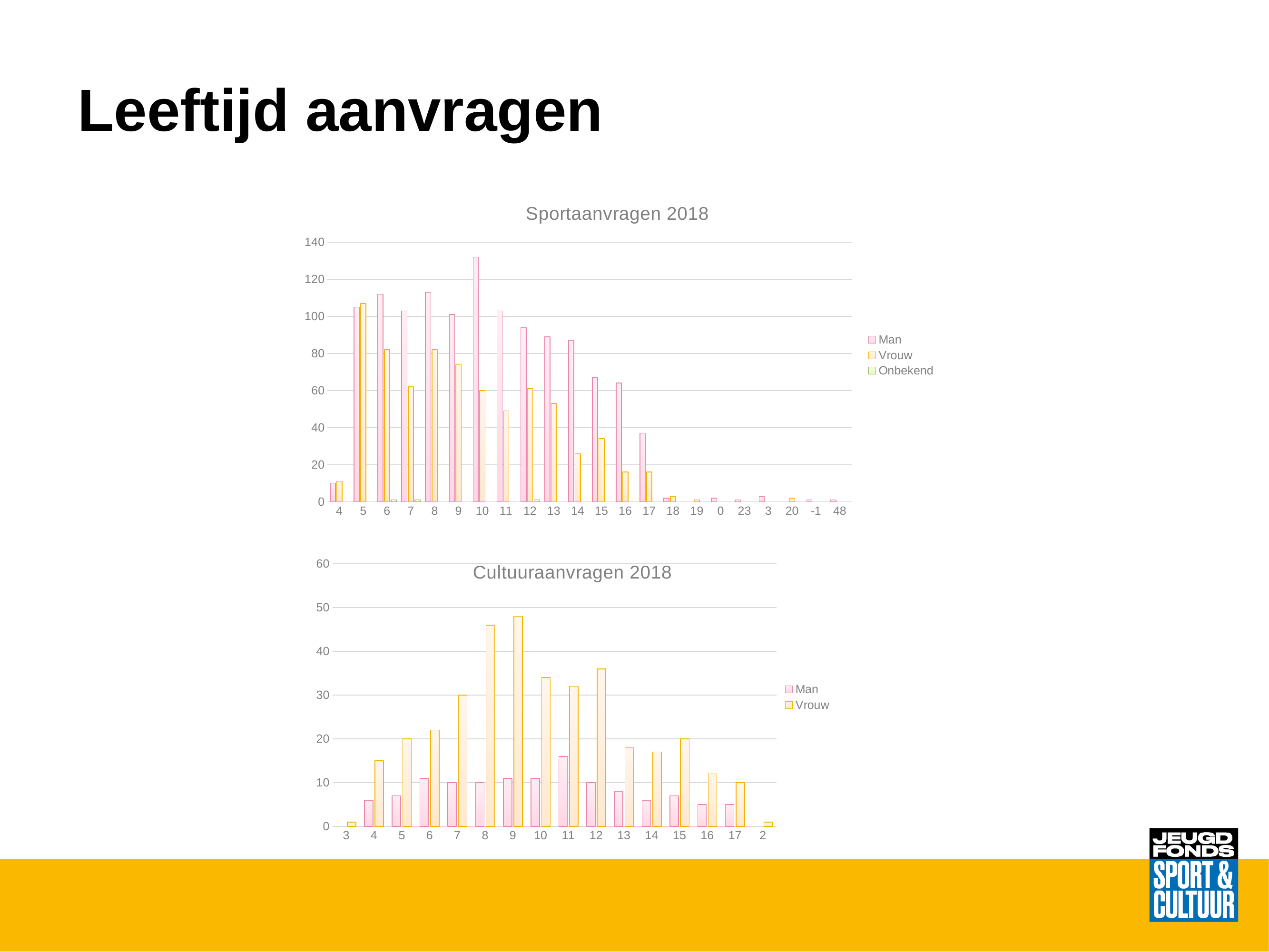
In the Sportaanvragen 2018 chart, which is larger at age 12, Man or Vrouw? Man What kind of chart is the Sportaanvragen 2018 chart? bar chart How many series does the legend of the Cultuuraanvragen 2018 chart list? 2 In the Sportaanvragen 2018 chart, is the Man value for age 10 greater or less than 120? greater How many series does the legend of the Sportaanvragen 2018 chart list? 3 In the Sportaanvragen 2018 chart, at which age category is the Man series highest? 10 In the Cultuuraanvragen 2018 chart, is the Vrouw value for age 9 greater or less than 40? greater How many age categories are shown on the x axis of the Cultuuraanvragen 2018 chart? 16 Which series appears in the legend of the Sportaanvragen 2018 chart but not in the Cultuuraanvragen 2018 chart? Onbekend In the Sportaanvragen 2018 chart, is the Vrouw value for age 14 greater or less than 40? less In the Cultuuraanvragen 2018 chart, which is larger at age 8, Man or Vrouw? Vrouw